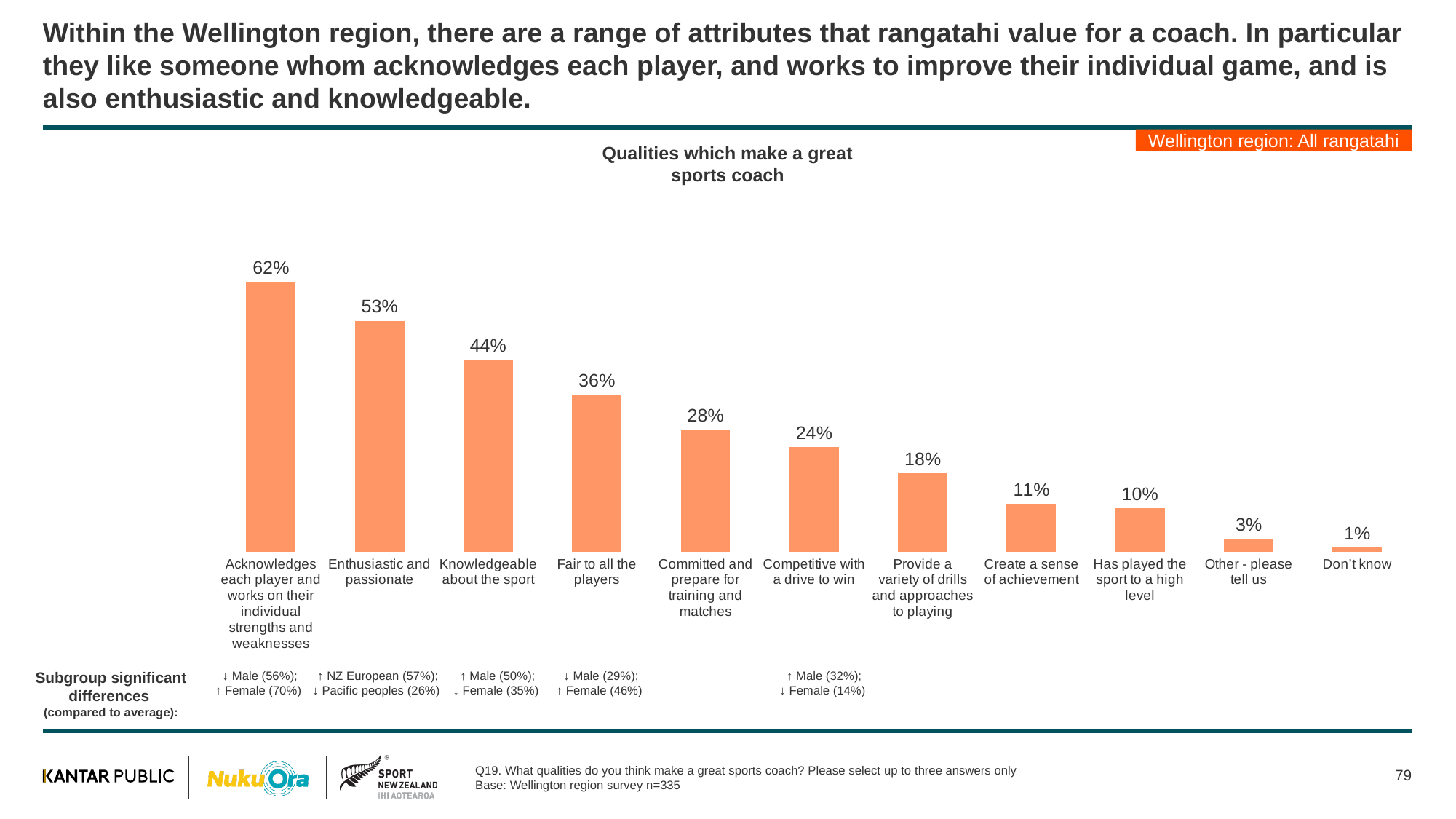
What type of chart is shown on the slide? Bar chart What is the title of the chart? Qualities which make a great sports coach Which quality has the highest percentage in the chart? Acknowledges each player and works on their individual strengths and weaknesses Do the values rise or fall moving from left to right across the chart? Fall What is the difference between the values for 'Knowledgeable about the sport' and 'Competitive with a drive to win'? 20% Which has a higher value: 'Committed and prepare for training and matches' or 'Provide a variety of drills and approaches to playing'? Committed and prepare for training and matches What percentage of rangatahi selected 'Enthusiastic and passionate' as a quality of a great sports coach? 53% How many categories are shown in the chart? 11 What is the difference between the values for 'Create a sense of achievement' and 'Other - please tell us'? 8% Which category has the lowest value in the chart? Don't know What is the value shown for 'Fair to all the players'? 36% What percentage is shown for 'Has played the sport to a high level'? 10%